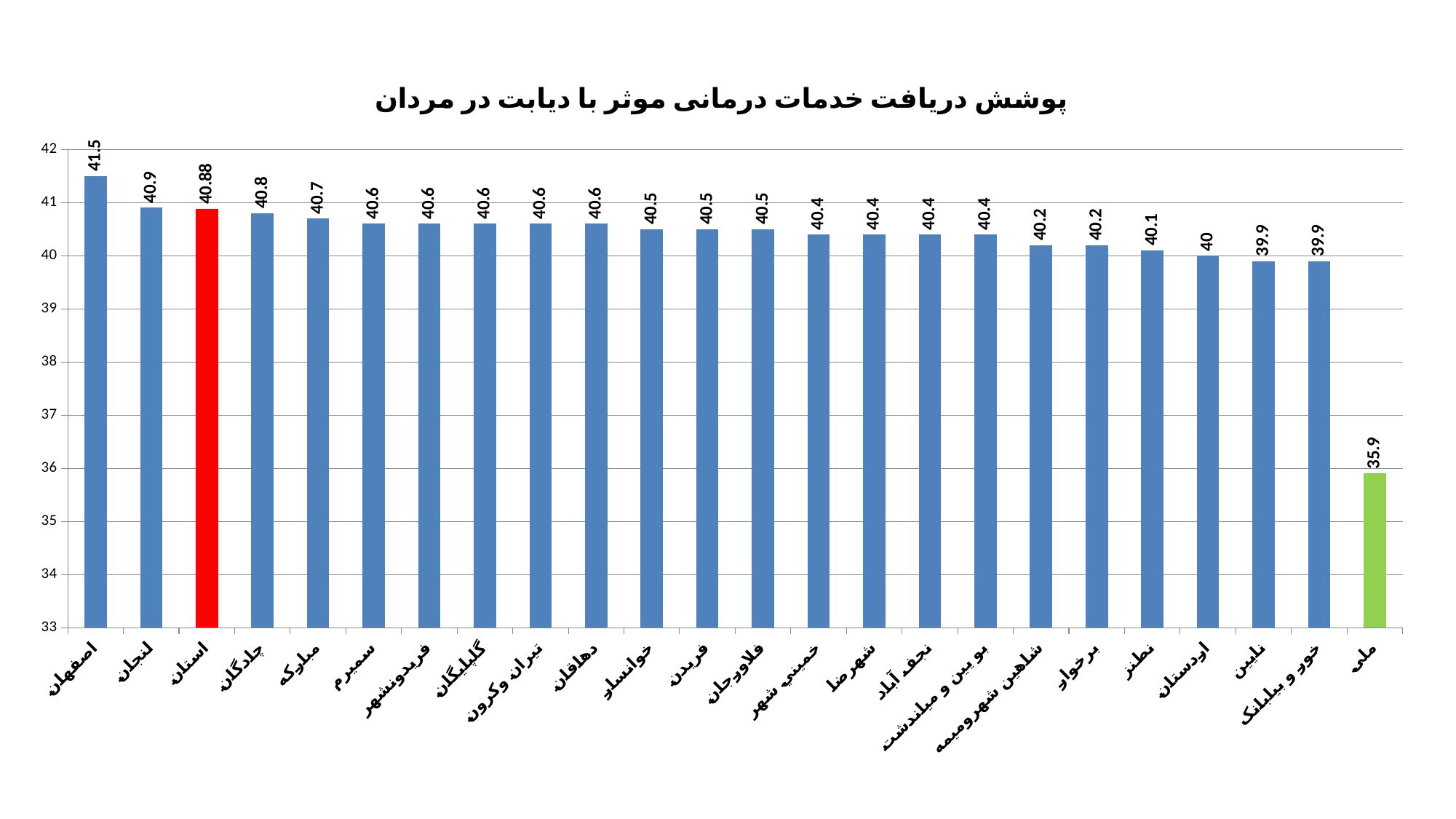
What is the value for استان (the red bar)? 40.88 How many bars are shown in the chart? 24 What is the title of the chart? پوشش دریافت خدمات درمانی موثر با دیابت در مردان Which is larger, the value for لنجان or the value for اردستان? لنجان What kind of chart is shown on the slide? bar chart What is the value for نطنز? 40.1 Which category has the highest value? اصفهان What is the difference between the values for اصفهان and ملی? 5.6 Which category has the lowest value? ملی What is the value for اصفهان? 41.5 Is the value for ملی greater or less than 36? less What is the value for ملی (the green bar)? 35.9